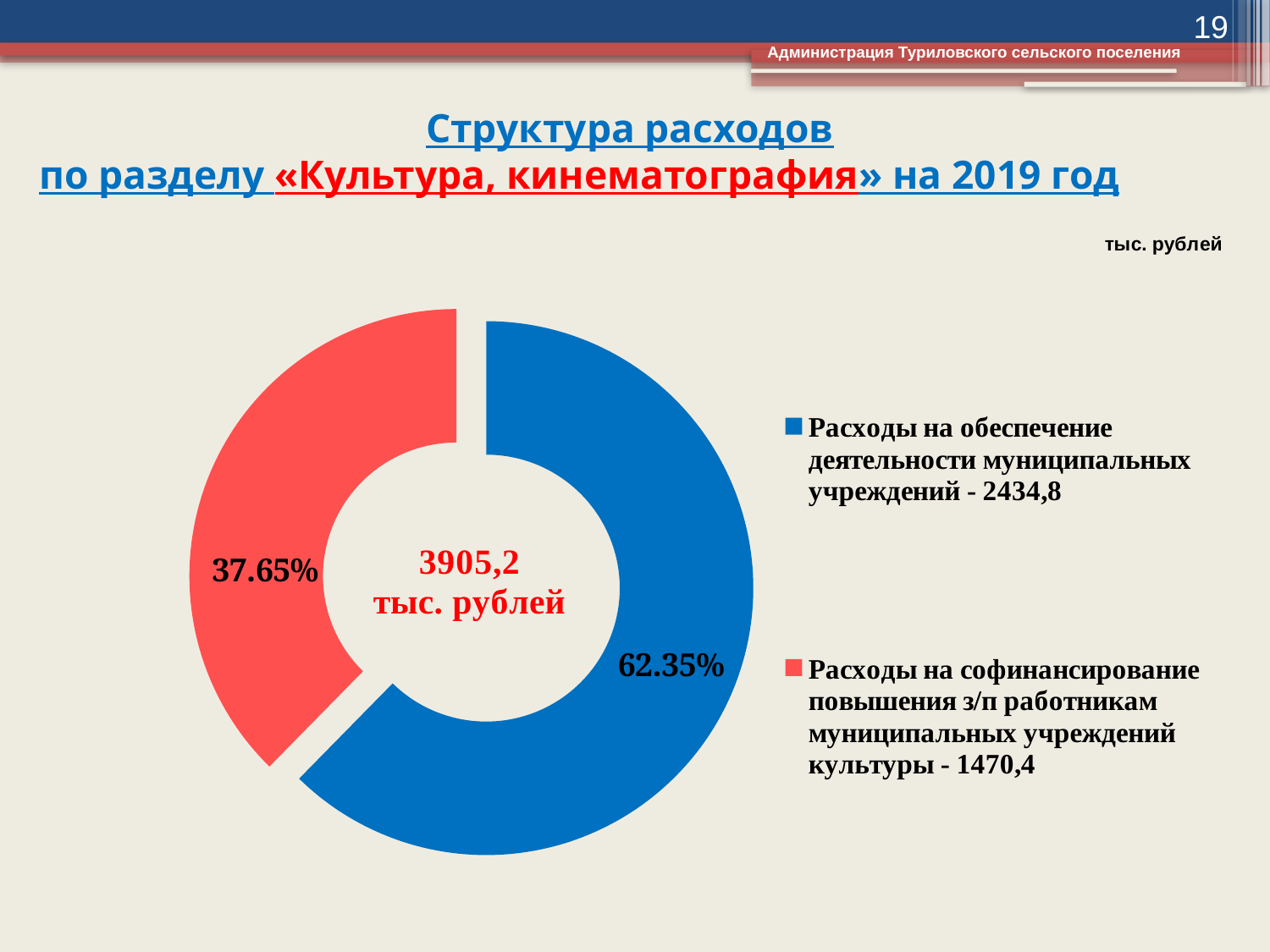
Which is larger: the share for «Расходы на обеспечение деятельности муниципальных учреждений» or the share for «Расходы на софинансирование повышения з/п работникам муниципальных учреждений культуры»? Расходы на обеспечение деятельности муниципальных учреждений Which category has the smallest share of the chart? Расходы на софинансирование повышения з/п работникам муниципальных учреждений культуры What value (тыс. рублей) is given in the legend for «Расходы на софинансирование повышения з/п работникам муниципальных учреждений культуры»? 1470,4 What value (тыс. рублей) is given in the legend for «Расходы на обеспечение деятельности муниципальных учреждений»? 2434,8 What colour is the slice for «Расходы на софинансирование повышения з/п работникам муниципальных учреждений культуры»? Red What total amount is shown in the centre of the doughnut chart? 3905,2 тыс. рублей What kind of chart is shown on the slide? Doughnut (pie) chart Which category has the largest share of the chart? Расходы на обеспечение деятельности муниципальных учреждений What is the difference in percentage points between the two slices of the chart? 24.7 percentage points What share of the chart does the slice «Расходы на софинансирование повышения з/п работникам муниципальных учреждений культуры» take? 37.65% What share of the chart does the slice «Расходы на обеспечение деятельности муниципальных учреждений» take? 62.35% How many categories (slices) does the chart have? 2